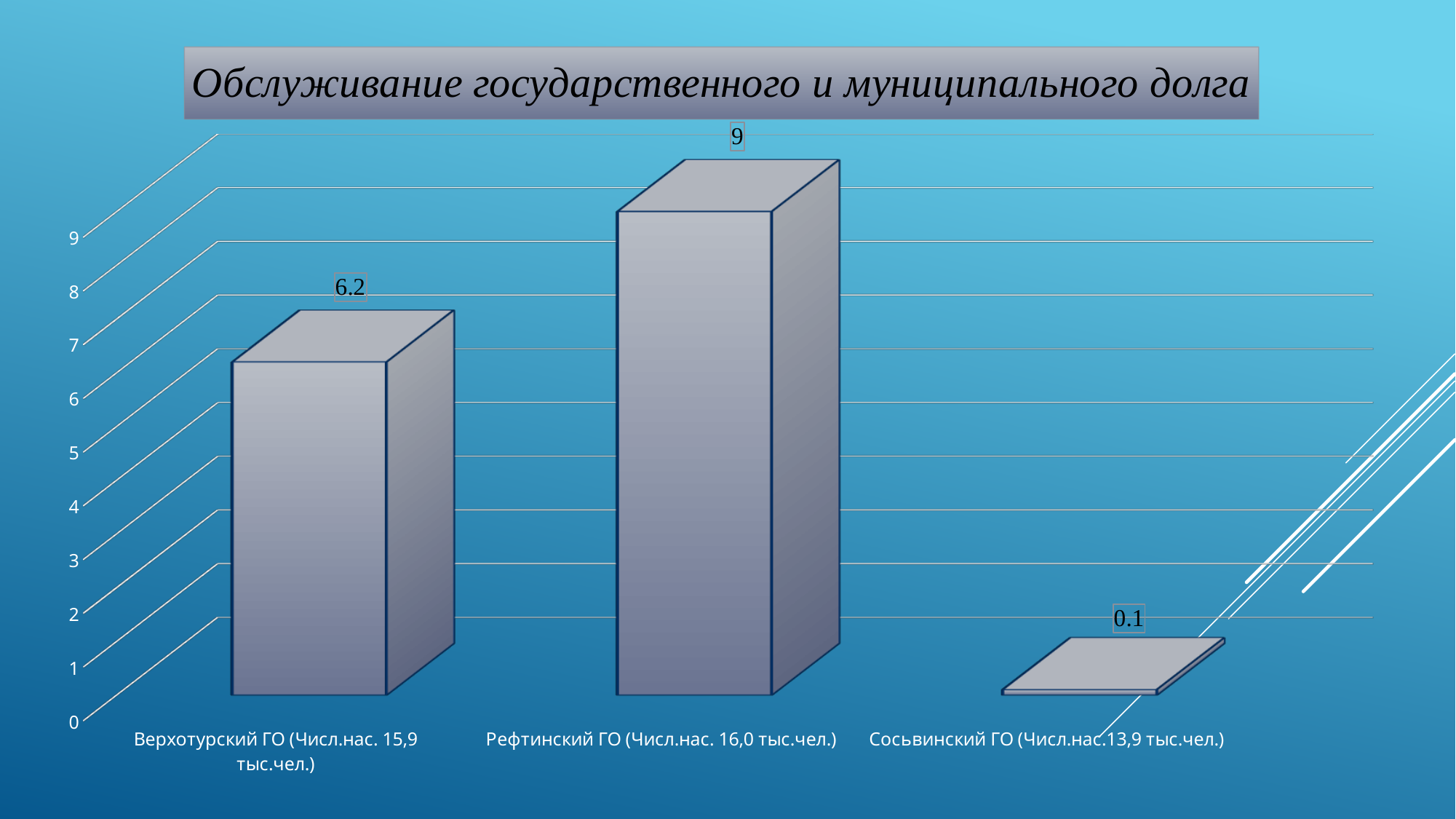
Which is larger, the value for Верхотурский ГО or the value for Сосьвинский ГО? Верхотурский ГО What is the title of the chart? Обслуживание государственного и муниципального долга Which category has the highest value? Рефтинский ГО (Числ.нас. 16,0 тыс.чел.) What is the difference between the values for Верхотурский ГО and Сосьвинский ГО? 6.1 What is the difference between the values for Рефтинский ГО and Верхотурский ГО? 2.8 What is the value for Рефтинский ГО (Числ.нас. 16,0 тыс.чел.)? 9 Which category has the lowest value? Сосьвинский ГО (Числ.нас.13,9 тыс.чел.) How many categories are shown in the chart? 3 What kind of chart is shown on the slide? bar chart What is the value for Сосьвинский ГО (Числ.нас.13,9 тыс.чел.)? 0.1 Is the value for Верхотурский ГО greater or less than 5? greater What is the value for Верхотурский ГО (Числ.нас. 15,9 тыс.чел.)? 6.2